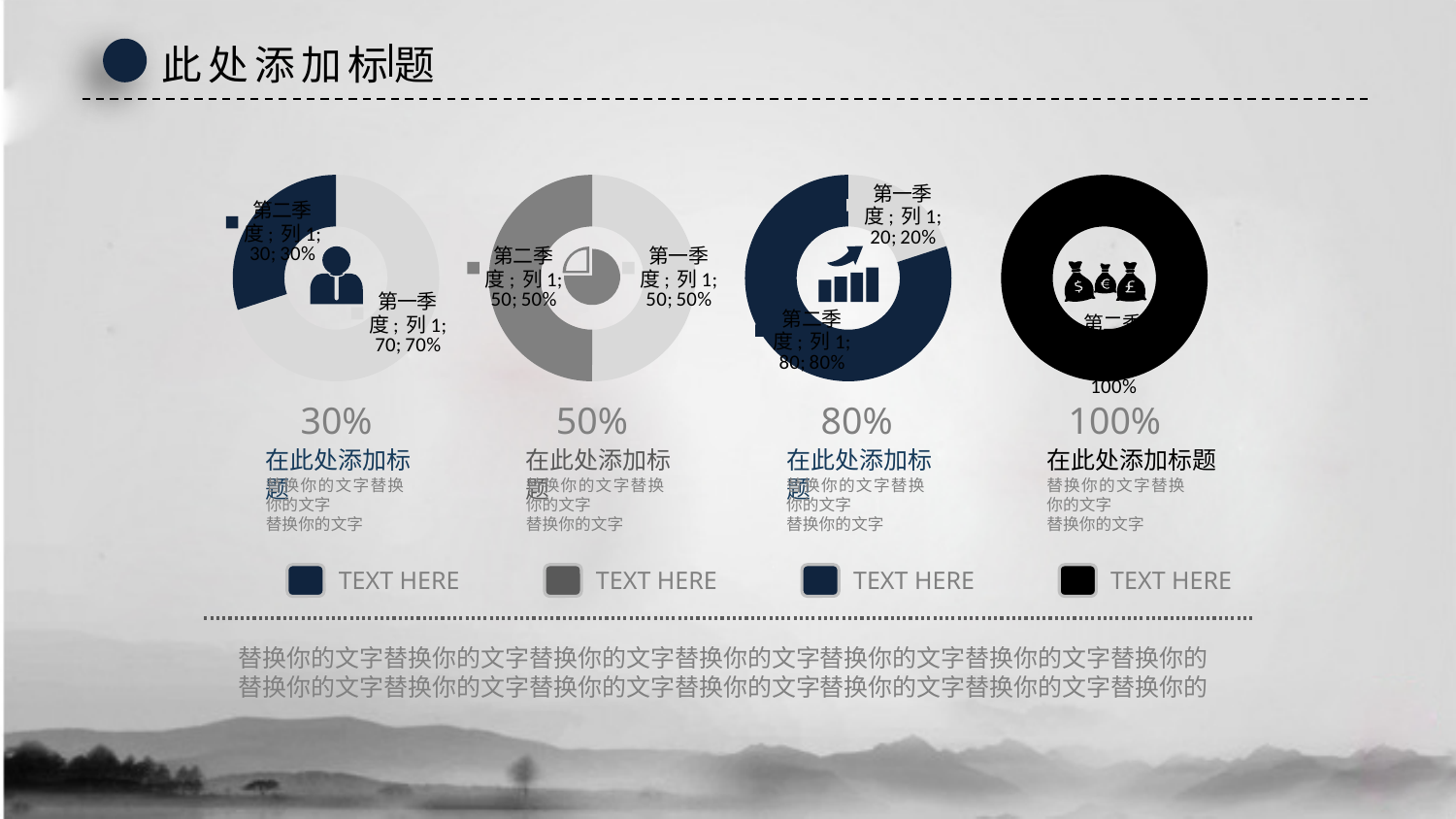
In the leftmost chart (above 30%), what is the value for 第一季度? 70 In the second chart from the left (above 50%), how many categories are plotted? 2 What kind of chart is the leftmost chart on the slide? doughnut chart How many doughnut charts are shown on the slide? 4 In the third chart from the left (above 80%), which is larger, 第一季度 or 第二季度? 第二季度 In the leftmost chart (above 30%), which category has the larger value? 第一季度 In the leftmost chart (above 30%), what is the value for 第二季度? 30 In the third chart from the left (above 80%), what is the value for 第一季度? 20 In the second chart from the left (above 50%), what is the value for 第一季度? 50 In the leftmost chart (above 30%), what share of the doughnut does 第一季度 take? 70% In the third chart from the left (above 80%), what share of the doughnut does 第二季度 take? 80% In the third chart from the left (above 80%), what is the difference between the values for 第二季度 and 第一季度? 60